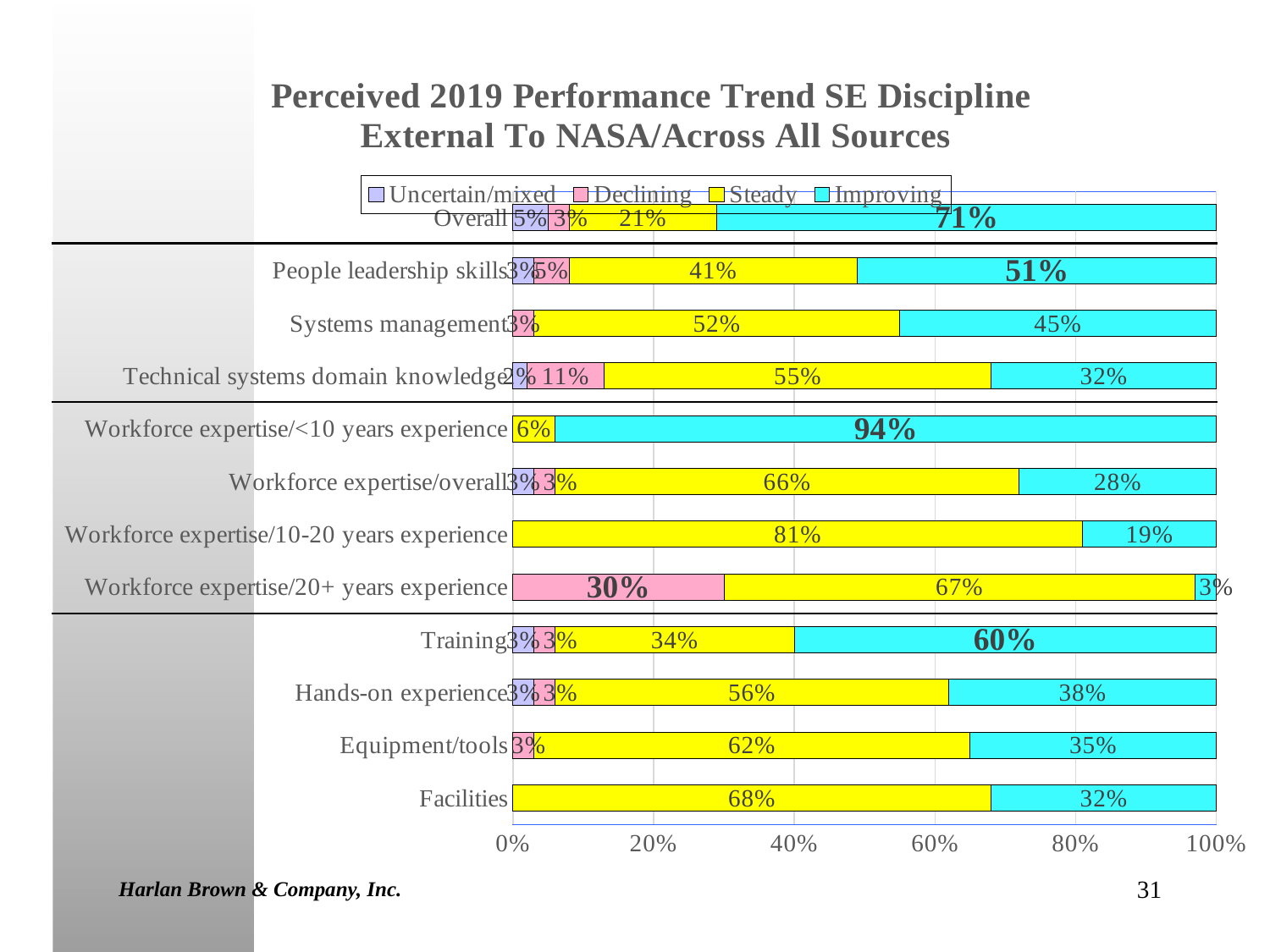
What is the Improving value for Overall? 71% How many series does the legend list? 4 What is the Declining value for Workforce expertise/20+ years experience? 30% Is the Improving value for Systems management greater or less than 40%? greater Which category has the highest Steady value? Workforce expertise/10-20 years experience What is the difference between the Improving values for Training and Hands-on experience? 22% How many categories are plotted on the chart? 12 What is the title of the chart? Perceived 2019 Performance Trend SE Discipline External To NASA/Across All Sources Which is larger, the Steady value for Facilities or the Steady value for Equipment/tools? Facilities What kind of chart is shown on the slide? Stacked bar chart What is the Steady value for Workforce expertise/10-20 years experience? 81% Which category has the highest Improving value? Workforce expertise/<10 years experience